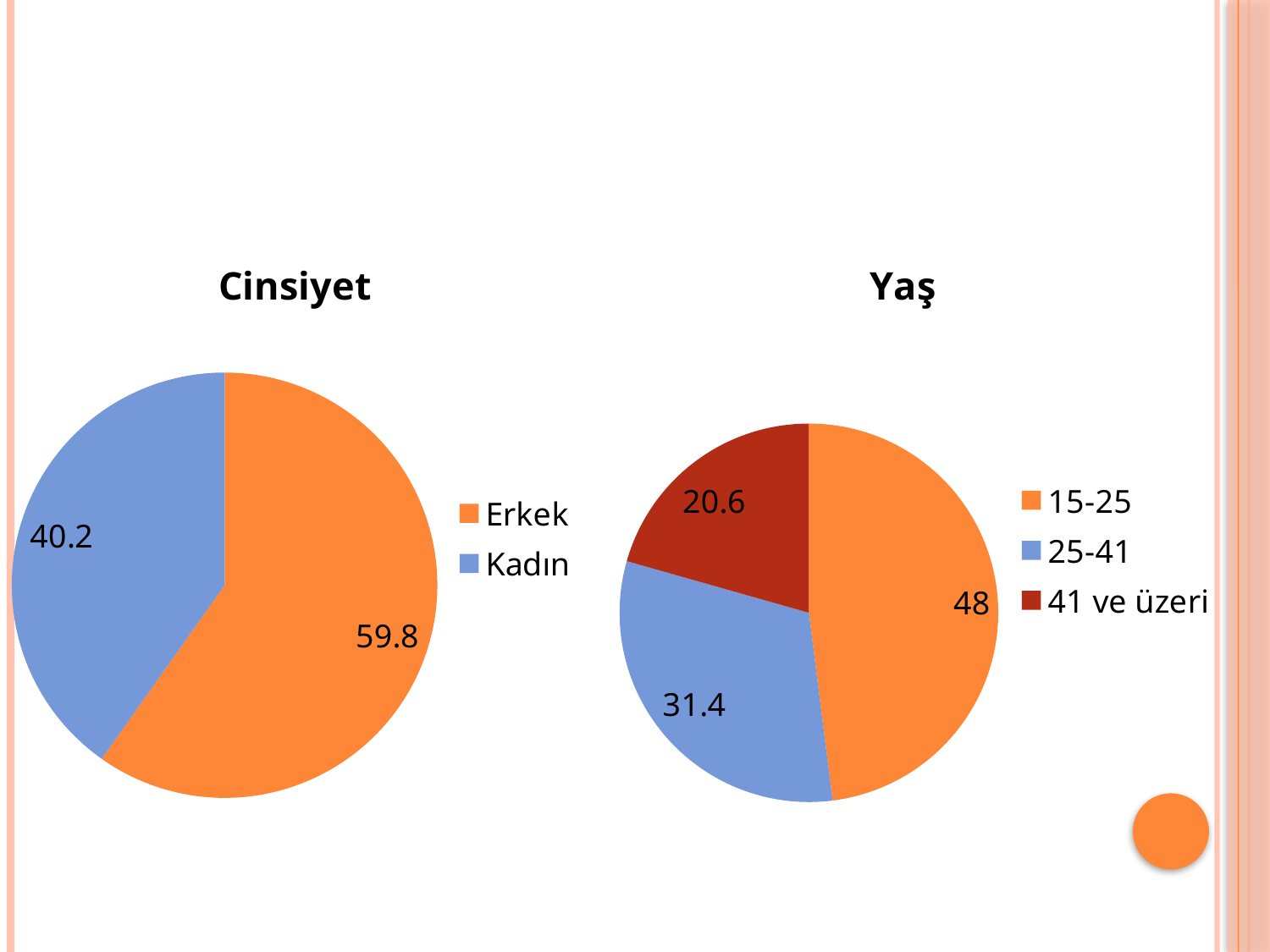
In the "Cinsiyet" chart, how many slices does the pie have? 2 In the "Yaş" chart, which is larger, 25-41 or 41 ve üzeri? 25-41 In the "Cinsiyet" chart, what is the difference between the Erkek and Kadın values? 19.6 In the "Cinsiyet" chart, what is the value for Erkek? 59.8 In the "Cinsiyet" chart, what is the value for Kadın? 40.2 In the "Yaş" chart, which category has the smallest slice? 41 ve üzeri In the "Yaş" chart, what is the value for 15-25? 48 In the "Yaş" chart, what is the value for 41 ve üzeri? 20.6 In the "Cinsiyet" chart, which category has the larger slice? Erkek What kind of chart is the "Yaş" chart? Pie chart In the "Yaş" chart, what is the difference between the 15-25 and 25-41 values? 16.6 In the "Yaş" chart, how many entries does the legend list? 3